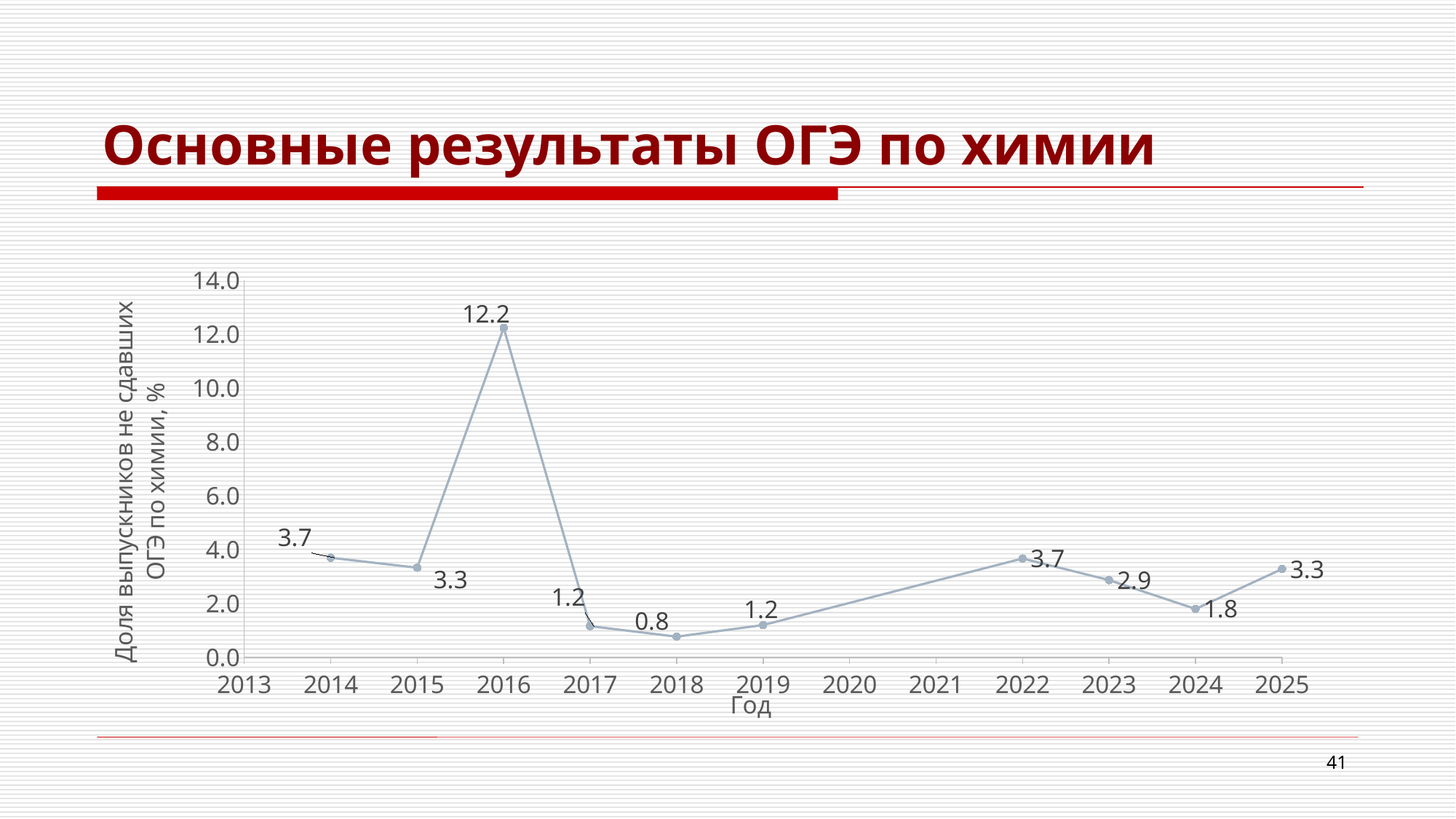
What is the difference between the values for 2016 and 2015? 8.9 What is the value for 2024? 1.8 What is the label of the x axis? Год What is the value for 2023? 2.9 Which year has the highest value? 2016 Which year has the lowest value? 2018 Which is larger, the value for 2022 or the value for 2023? 2022 What is the value for 2018? 0.8 Is the value for 2016 greater or less than 10.0? greater What kind of chart is shown on the slide? line chart How many data points are plotted on the line? 10 What is the value for 2016? 12.2